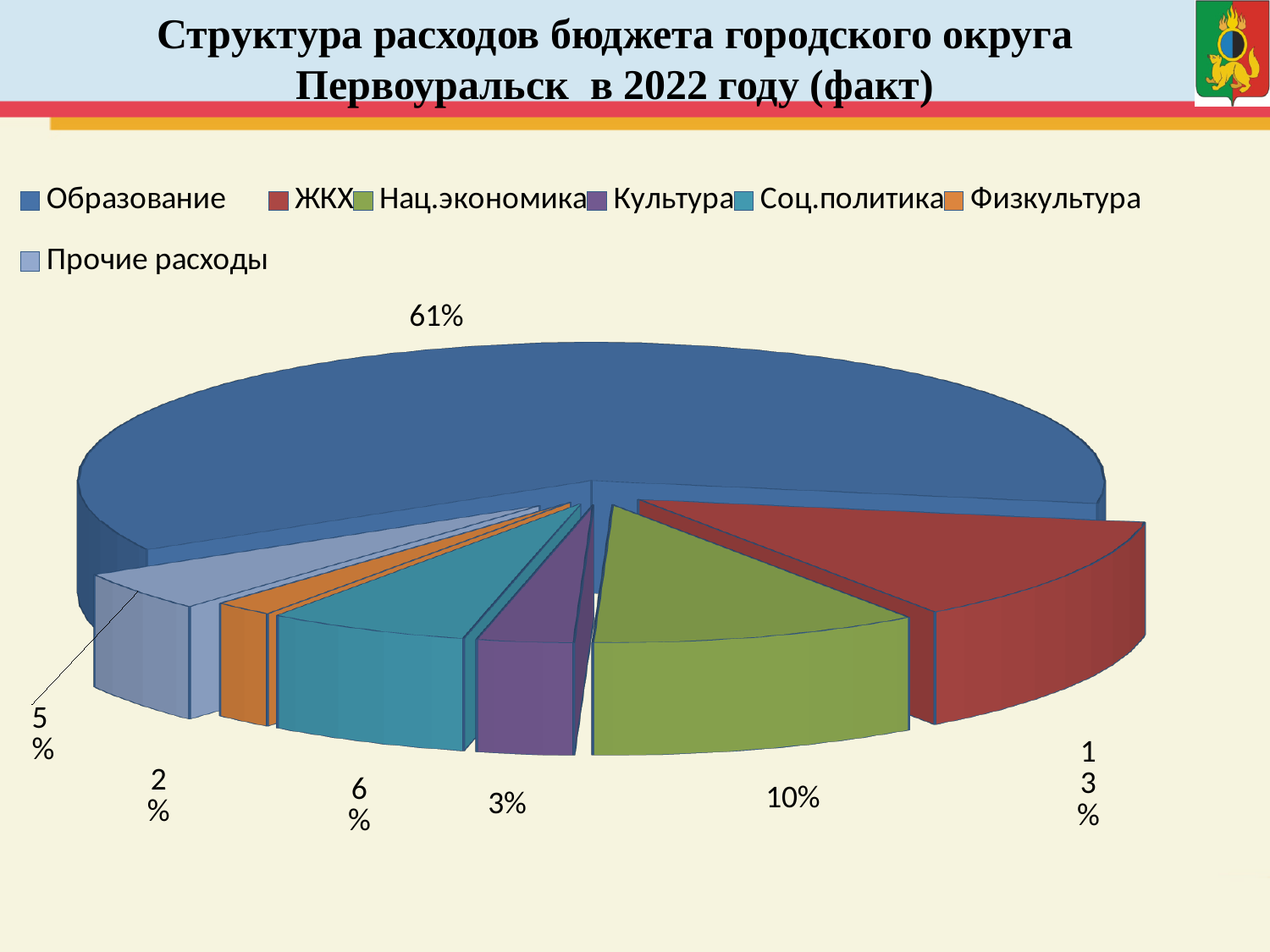
What share of the budget expenditure goes to Прочие расходы? 5% What share of the budget expenditure goes to Соц.политика? 6% Which category has the largest share of the pie? Образование What is the difference in percentage points between the shares of ЖКХ and Нац.экономика? 3 What is the title of the chart on the slide? Структура расходов бюджета городского округа Первоуральск в 2022 году (факт) Which has a larger share, Культура or Соц.политика? Соц.политика What share of the budget expenditure goes to Нац.экономика? 10% What kind of chart is shown on the slide? Pie chart How many categories does the legend list? 7 What share of the budget expenditure goes to Образование? 61% What share of the budget expenditure goes to ЖКХ? 13% Which category has the smallest share of the pie? Физкультура